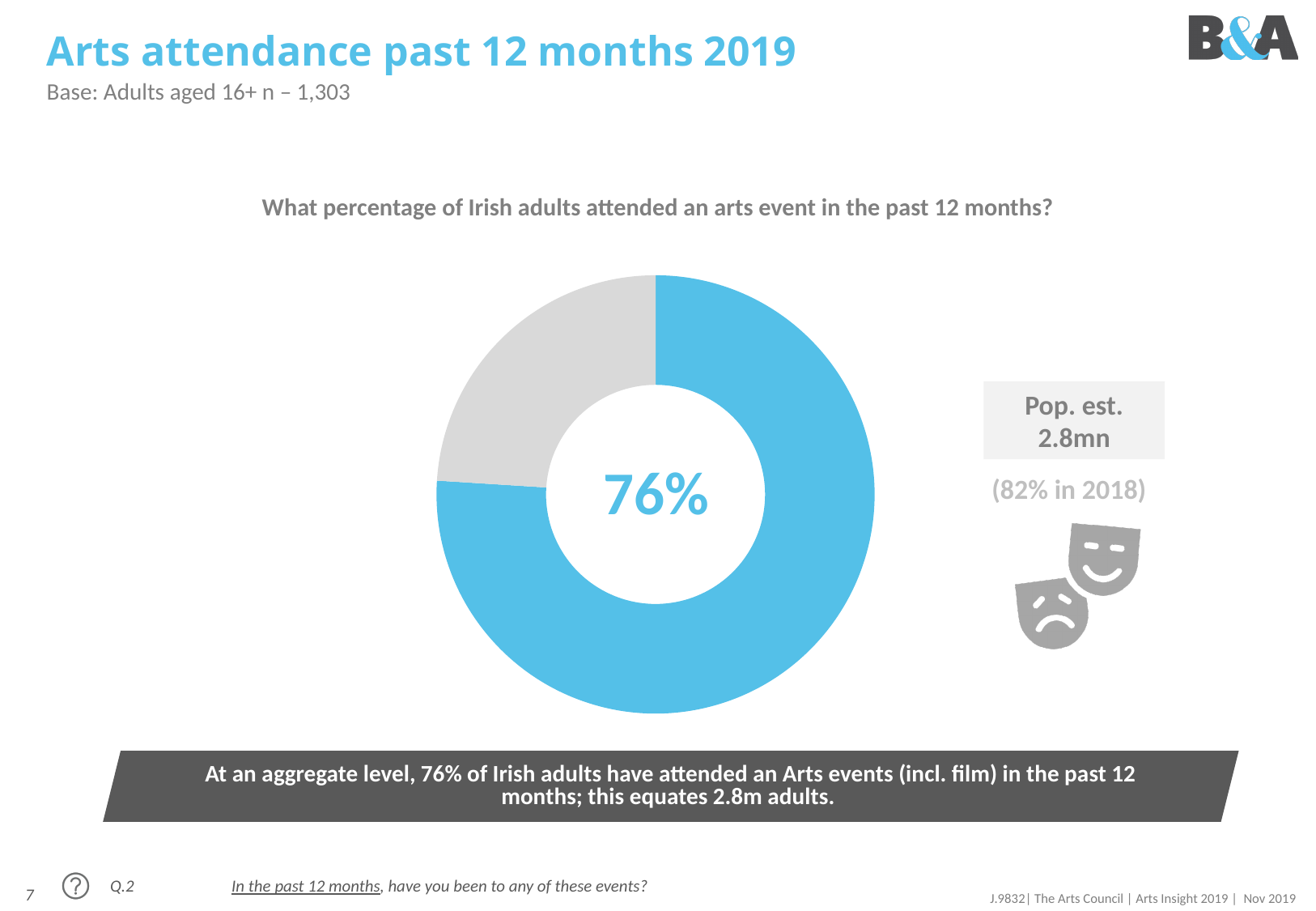
Which year had the higher arts attendance figure, 2018 or 2019? 2018 What kind of chart is shown on the slide? pie chart (donut) Which slice of the chart is the largest? the blue slice (76%) Which slice is larger, the blue slice or the grey slice? the blue slice What percentage of Irish adults attended an arts event in the past 12 months, according to the chart? 76% What share of the pie does the blue slice represent? 76% What population estimate is shown beside the chart? 2.8mn How many slices does the chart have? 2 By how many percentage points did arts attendance change from 2018 (82%) to 2019 (76%)? 6 percentage points What was the arts attendance figure in 2018, as shown beside the chart? 82%